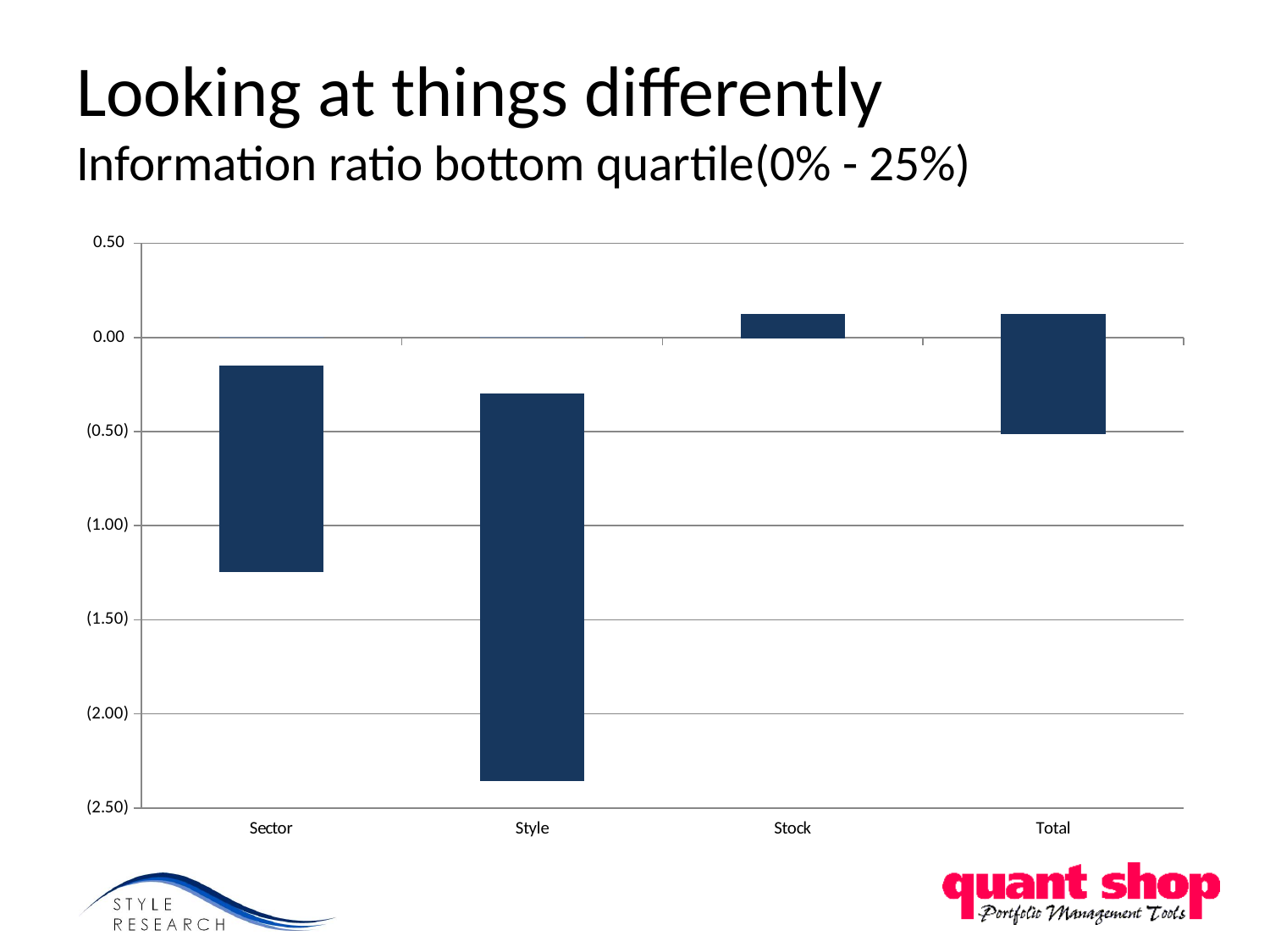
Which category has the shortest bar on the chart? Stock Which bar extends lower, Sector or Style? Style What is the subtitle of the chart on the slide? Information ratio bottom quartile(0% - 25%) Is the lowest point of the Total bar greater or less than (1.00)? greater Is the lowest point of the Sector bar greater or less than (1.00)? less How many categories are shown on the x axis of the chart? 4 Is the lowest point of the Style bar greater or less than (2.00)? less Which category's bar extends to the lowest value on the chart? Style Which category has the longest bar (largest range) on the chart? Style Which bar reaches a higher value at its top, Stock or Sector? Stock What kind of chart is shown on the slide? bar chart